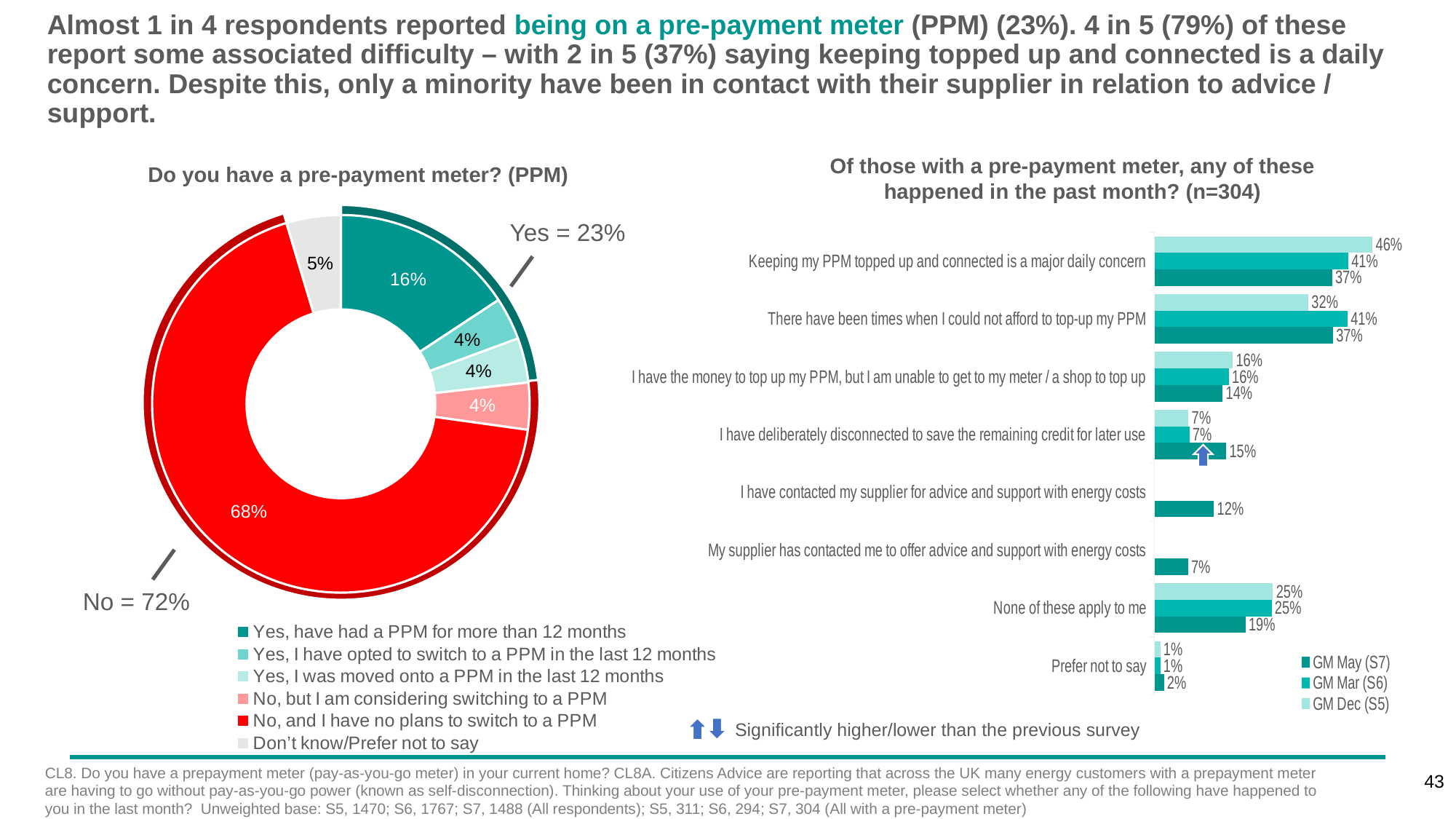
In the bar chart 'Of those with a pre-payment meter, any of these happened in the past month?', what is the GM Dec (S5) value for 'Keeping my PPM topped up and connected is a major daily concern'? 46% In the bar chart 'Of those with a pre-payment meter, any of these happened in the past month?', what is the difference between the GM Dec (S5) and GM May (S7) values for 'Keeping my PPM topped up and connected is a major daily concern'? 9% In the bar chart 'Of those with a pre-payment meter, any of these happened in the past month?', which is larger for 'There have been times when I could not afford to top-up my PPM': the GM Mar (S6) value or the GM Dec (S5) value? GM Mar (S6) In the bar chart 'Of those with a pre-payment meter, any of these happened in the past month?', how many series does the legend list? 3 In the donut chart 'Do you have a pre-payment meter? (PPM)', what percentage said 'Yes, have had a PPM for more than 12 months'? 16% In the donut chart 'Do you have a pre-payment meter? (PPM)', what is the combined 'Yes' share shown on the chart? 23% In the donut chart 'Do you have a pre-payment meter? (PPM)', how many categories does the legend list? 6 In the donut chart 'Do you have a pre-payment meter? (PPM)', what percentage of respondents said 'No, and I have no plans to switch to a PPM'? 68% In the bar chart 'Of those with a pre-payment meter, any of these happened in the past month?', what is the GM May (S7) value for 'Keeping my PPM topped up and connected is a major daily concern'? 37% In the donut chart 'Do you have a pre-payment meter? (PPM)', which category has the largest share? No, and I have no plans to switch to a PPM In the bar chart 'Of those with a pre-payment meter, any of these happened in the past month?', what is the GM May (S7) value for 'I have deliberately disconnected to save the remaining credit for later use'? 15% What kind of chart is 'Of those with a pre-payment meter, any of these happened in the past month?'? Bar chart